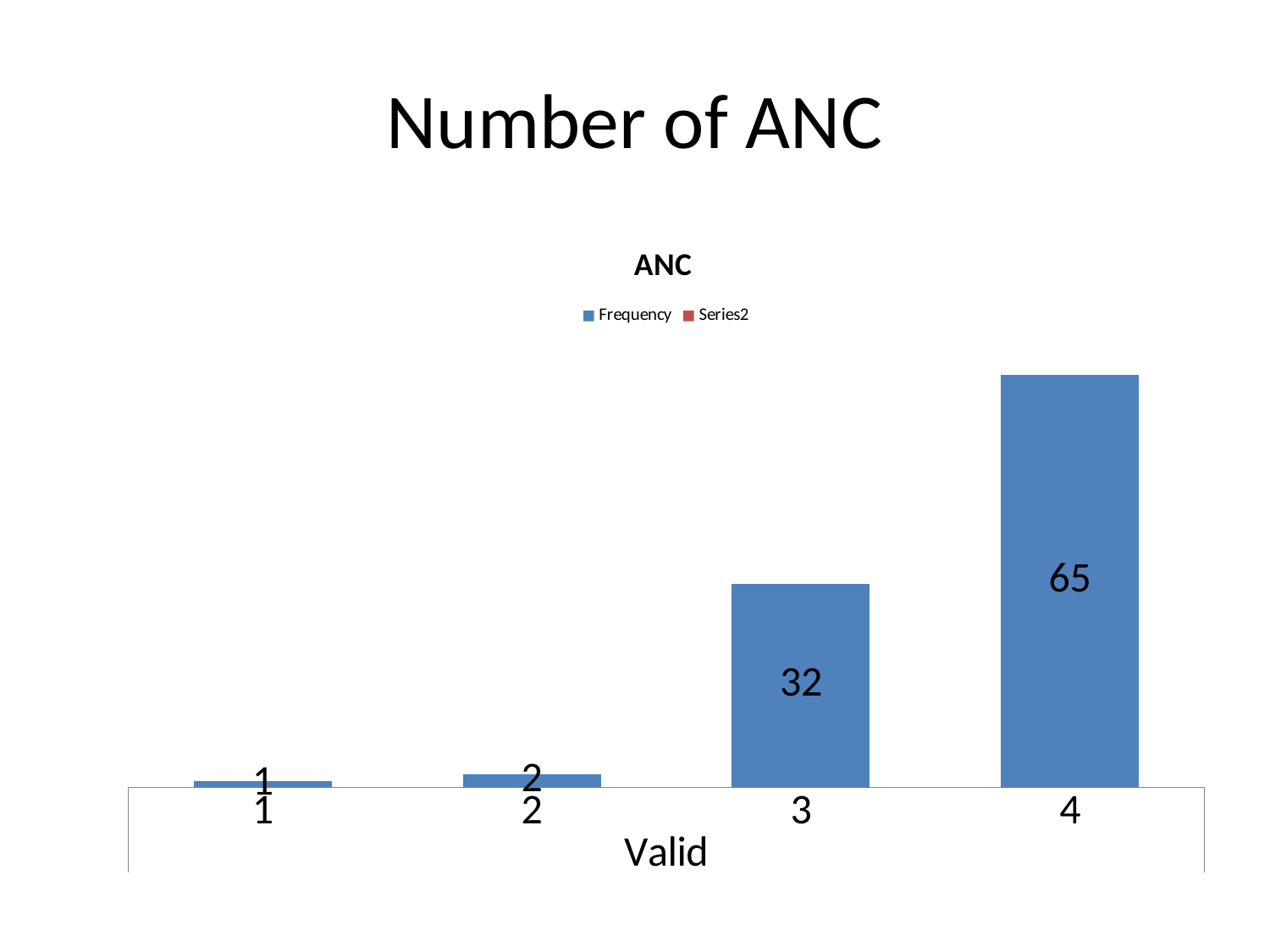
Which category has the highest Frequency? 4 What is the Frequency value for category 3? 32 How many categories are shown on the x axis? 4 Which has a larger Frequency, category 2 or category 3? 3 Which category has the lowest Frequency? 1 What is the Frequency value for category 1? 1 What kind of chart is shown? bar chart What is the Frequency value for category 2? 2 What is the Frequency value for category 4? 65 Do the Frequency values rise or fall from category 1 to category 4? rise What is the difference in Frequency between category 4 and category 3? 33 How many series does the legend list? 2